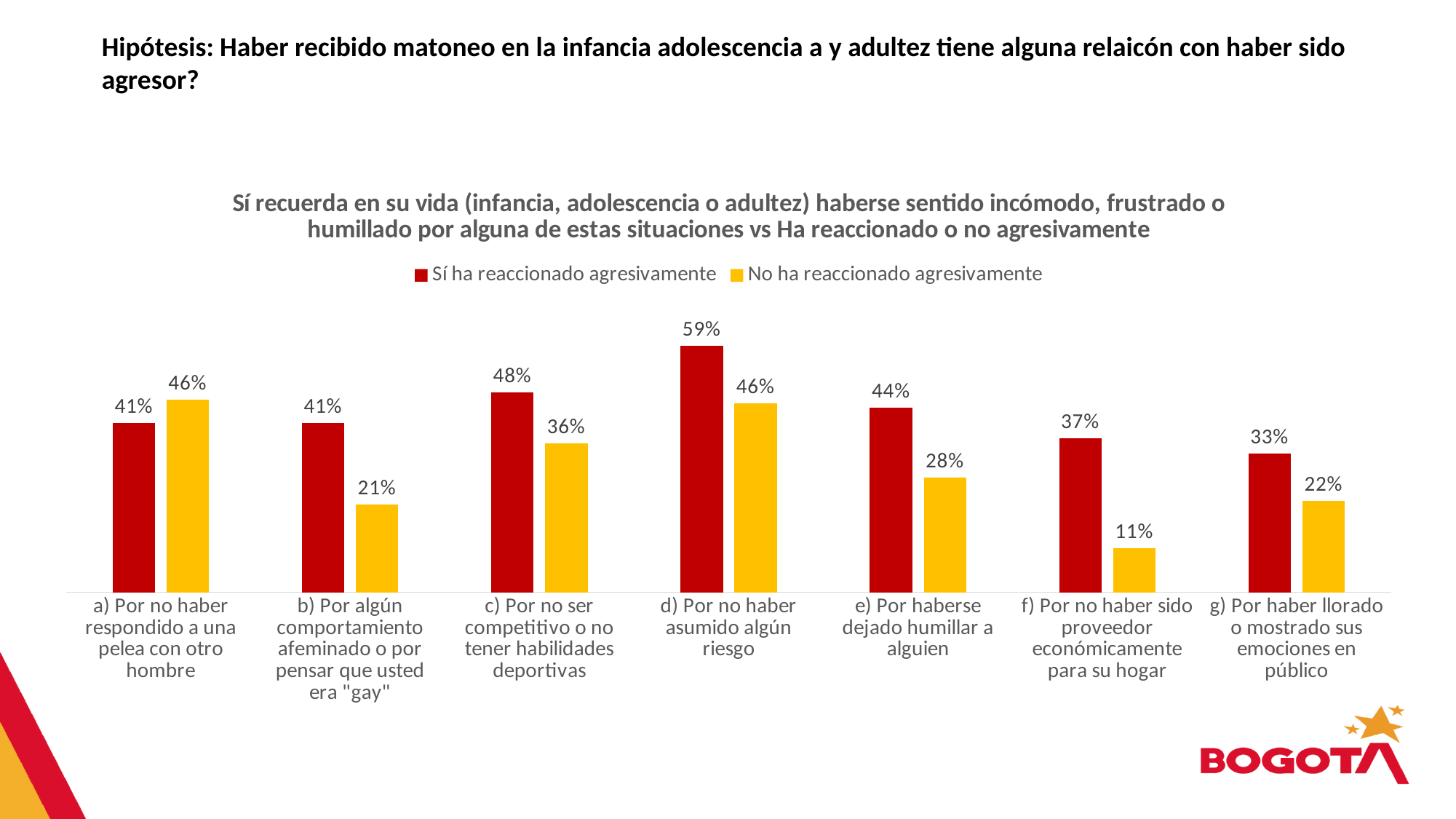
In category a) Por no haber respondido a una pelea con otro hombre, which series has the larger value? No ha reaccionado agresivamente What kind of chart is shown on the slide? Bar chart What is the difference between the "Sí ha reaccionado agresivamente" and "No ha reaccionado agresivamente" values in category e) Por haberse dejado humillar a alguien? 16% What is the value for "Sí ha reaccionado agresivamente" in category d) Por no haber asumido algún riesgo? 59% What is the value for "No ha reaccionado agresivamente" in category b) Por algún comportamiento afeminado o por pensar que usted era "gay"? 21% How many series does the legend list? 2 What is the difference between the "Sí ha reaccionado agresivamente" value in category d) and the "Sí ha reaccionado agresivamente" value in category g) Por haber llorado o mostrado sus emociones en público? 26% Which category has the lowest value for "No ha reaccionado agresivamente"? f) Por no haber sido proveedor económicamente para su hogar What colour represents the series "Sí ha reaccionado agresivamente"? Red How many categories are shown on the x axis? 7 What is the value for "No ha reaccionado agresivamente" in category f) Por no haber sido proveedor económicamente para su hogar? 11% Which category has the highest value for "Sí ha reaccionado agresivamente"? d) Por no haber asumido algún riesgo